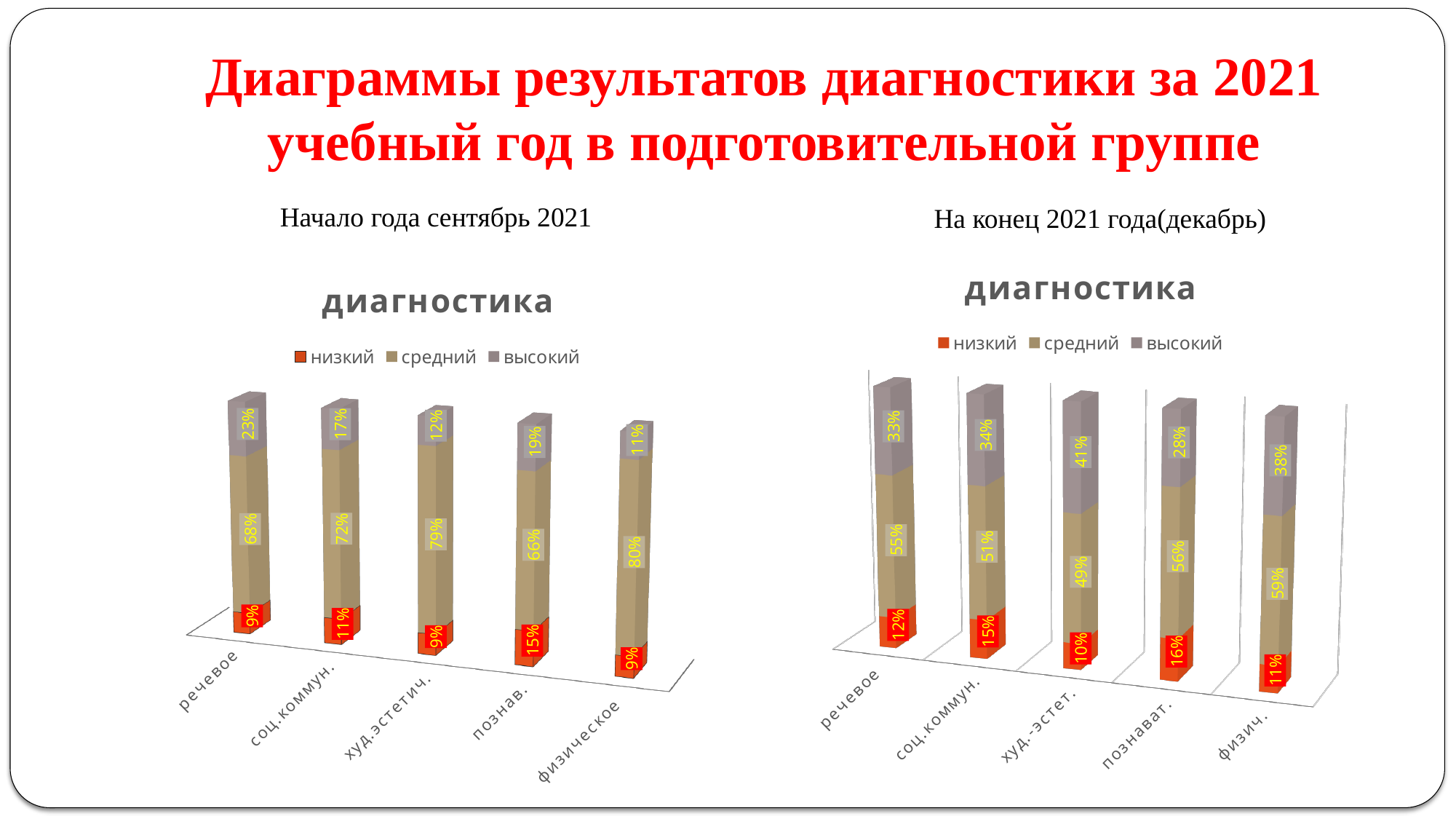
In the right chart (На конец 2021 года(декабрь)), what is the value of the низкий series for соц.коммун.? 15% In the right chart (На конец 2021 года(декабрь)), which category has the lowest value for the высокий series? познават. In the right chart (На конец 2021 года(декабрь)), what is the value of the высокий series for худ.-эстет.? 41% In the left chart (Начало года сентябрь 2021), which category has the highest value for the высокий series? речевое How many series does the legend of the left chart (Начало года сентябрь 2021) list? 3 What type of chart is the left chart (Начало года сентябрь 2021)? Stacked bar chart How many categories are shown in the right chart (На конец 2021 года(декабрь))? 5 In the right chart (На конец 2021 года(декабрь)), what is the difference between the средний values for физич. and худ.-эстет.? 10% In the left chart (Начало года сентябрь 2021), which is larger: the высокий value for соц.коммун. or for познав.? познав. What are the three legend entries of the right chart (На конец 2021 года(декабрь))? низкий, средний, высокий In the left chart (Начало года сентябрь 2021), what is the value of the средний series for физическое? 80% In the left chart (Начало года сентябрь 2021), what is the value of the низкий series for познав.? 15%